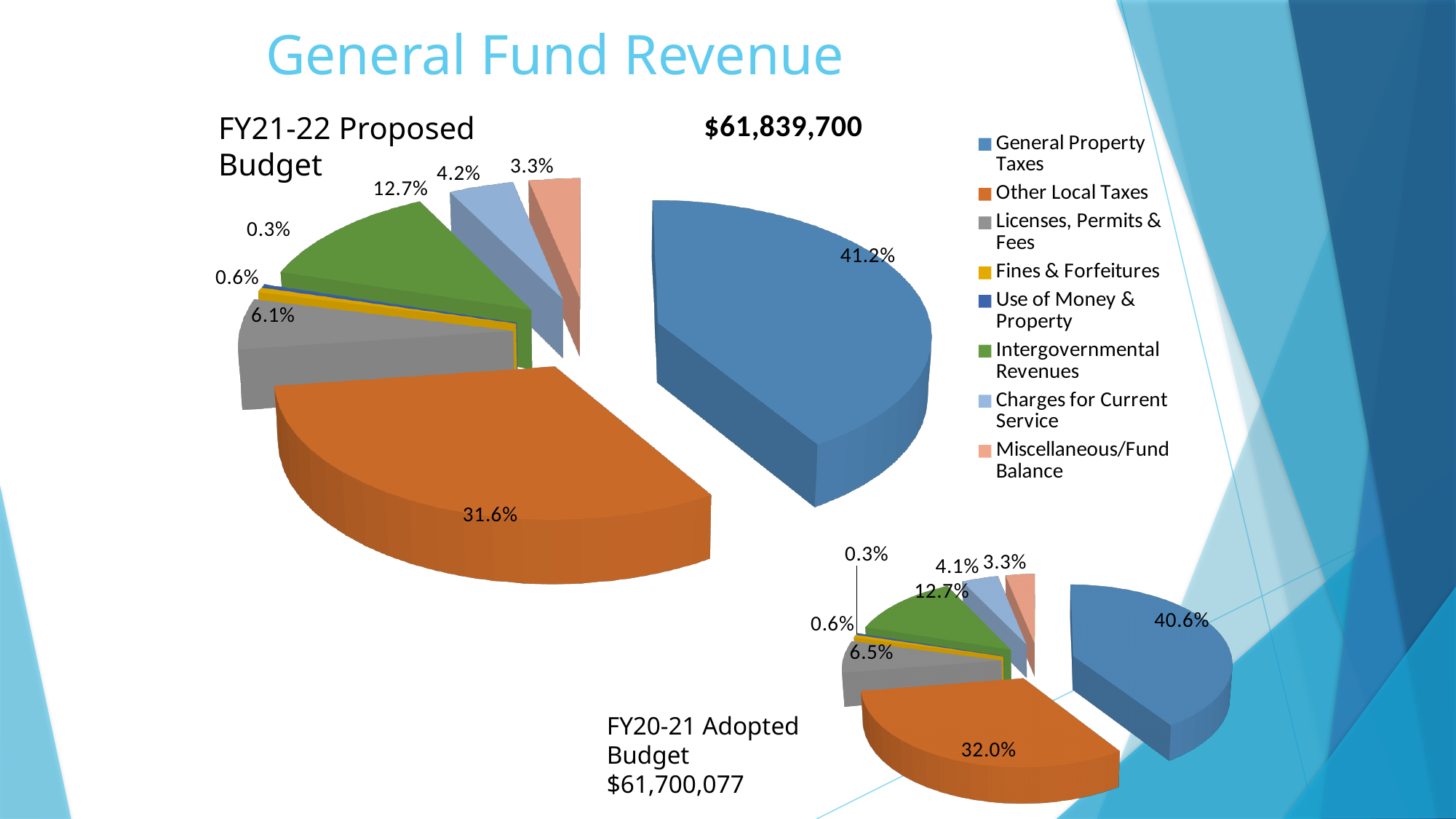
What type of chart is used to show the FY21-22 Proposed Budget? Pie chart In the FY21-22 Proposed Budget pie chart, which category has the largest share? General Property Taxes In the FY21-22 Proposed Budget pie chart, what share is General Property Taxes? 41.2% How many categories does the legend list for the pie charts? 8 In the FY21-22 Proposed Budget pie chart, what is the difference between the General Property Taxes share and the Other Local Taxes share? 9.6% What total amount is shown for the FY21-22 Proposed Budget? $61,839,700 In the FY21-22 Proposed Budget pie chart, what share is Intergovernmental Revenues? 12.7% In the FY20-21 Adopted Budget pie chart, what share is Licenses, Permits & Fees? 6.5% In the FY20-21 Adopted Budget pie chart, what share is General Property Taxes? 40.6% In the FY21-22 Proposed Budget pie chart, what share is Other Local Taxes? 31.6% In the FY20-21 Adopted Budget pie chart, which category has the smallest share? Use of Money & Property Which is larger: the Other Local Taxes share in the FY21-22 Proposed Budget chart or in the FY20-21 Adopted Budget chart? FY20-21 Adopted Budget